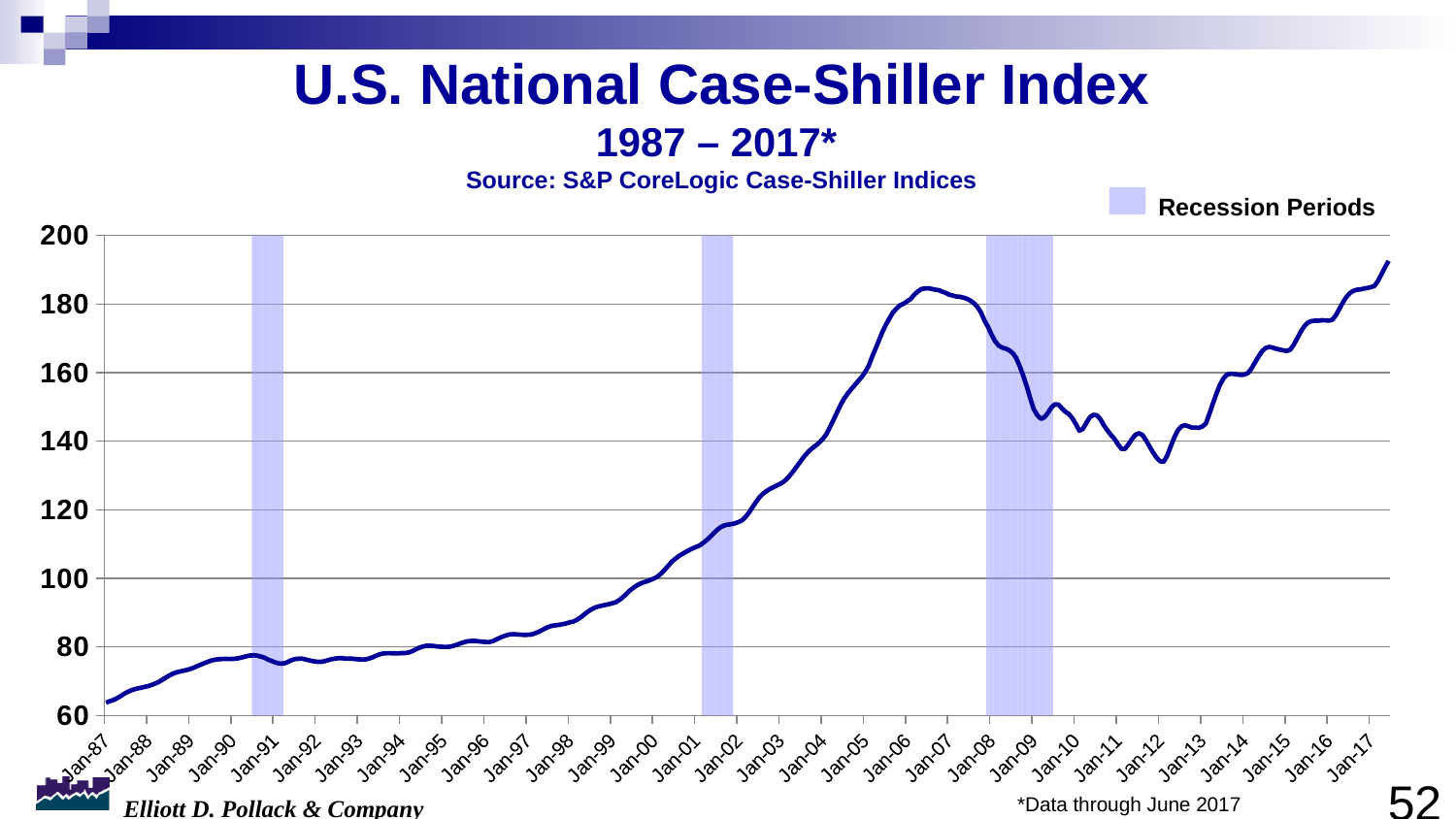
What is the title of the chart? U.S. National Case-Shiller Index Which is larger, the value for Jan-07 or the value for Jan-12? Jan-07 How many shaded recession periods are shown on the chart? 3 Is the value for Jan-05 greater or less than 140? greater What kind of chart is shown on the slide? line chart Does the index rise or fall between Jan-07 and Jan-12? fall Does the index rise or fall between Jan-12 and Jan-17? rise Is the value for Jan-17 greater or less than 180? greater Is the value for Jan-87 greater or less than 80? less What does the shaded legend entry on the chart represent? Recession Periods